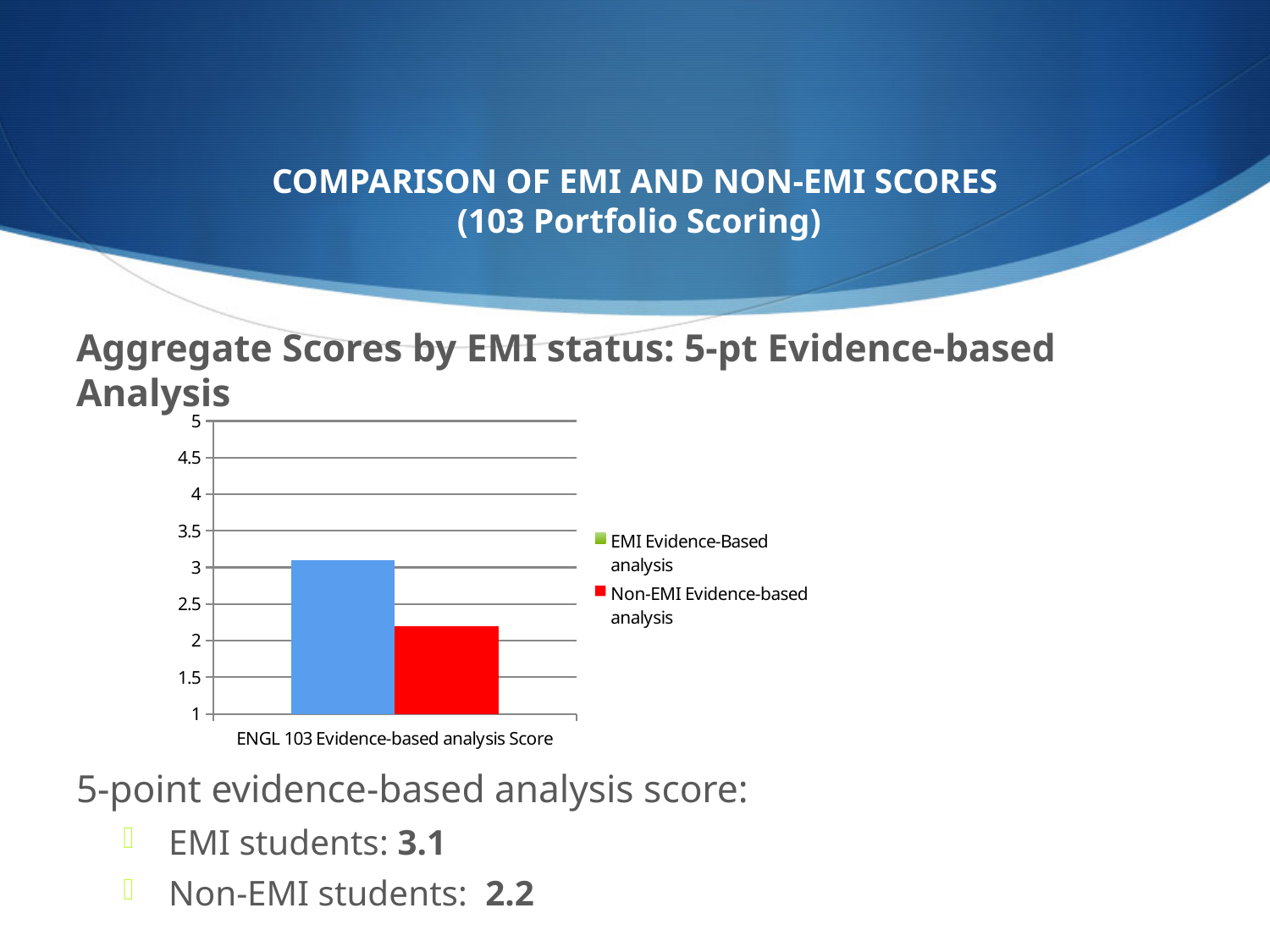
Which series has the higher value in the chart, EMI Evidence-Based analysis or Non-EMI Evidence-based analysis? EMI Evidence-Based analysis What is the maximum value shown on the chart's y axis? 5 Is the value for EMI Evidence-Based analysis greater or less than 2.5? greater How many series does the chart legend list? 2 What is the Non-EMI Evidence-based analysis score shown in the chart? 2.2 What type of chart is shown on the slide? bar chart Is the value for Non-EMI Evidence-based analysis greater or less than 2.5? less How many categories are shown on the x axis of the chart? 1 Which series has the lowest value in the chart? Non-EMI Evidence-based analysis What is the difference between the EMI and Non-EMI evidence-based analysis scores? 0.9 What is the EMI Evidence-Based analysis score shown in the chart? 3.1 What is the category label on the x axis of the chart? ENGL 103 Evidence-based analysis Score